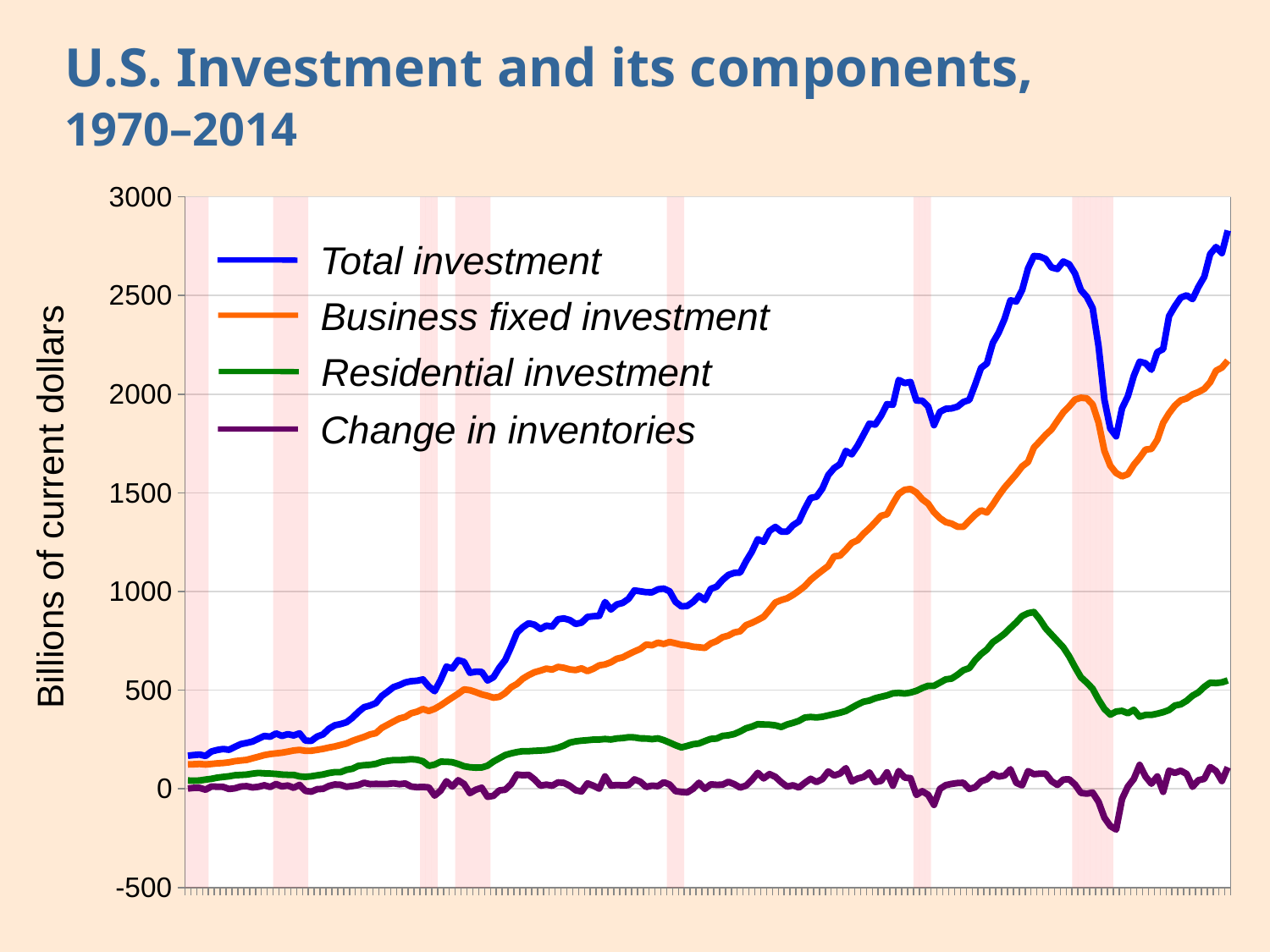
Is the highest value reached by Total investment greater or less than 2500? greater Is the value of Business fixed investment at the right end of the chart greater or less than 2000? greater What is the label on the vertical axis? Billions of current dollars Which series has the highest values throughout the chart? Total investment Which series has the lowest values throughout the chart? Change in inventories Is the highest value reached by Residential investment greater or less than 1000? less How many series does the legend list? 4 What is the title of the chart? U.S. Investment and its components, 1970–2014 Does Total investment generally rise or fall from the left to the right of the chart? rise What kind of chart is shown on the slide? line chart At the right end of the chart, which is larger: Business fixed investment or Residential investment? Business fixed investment